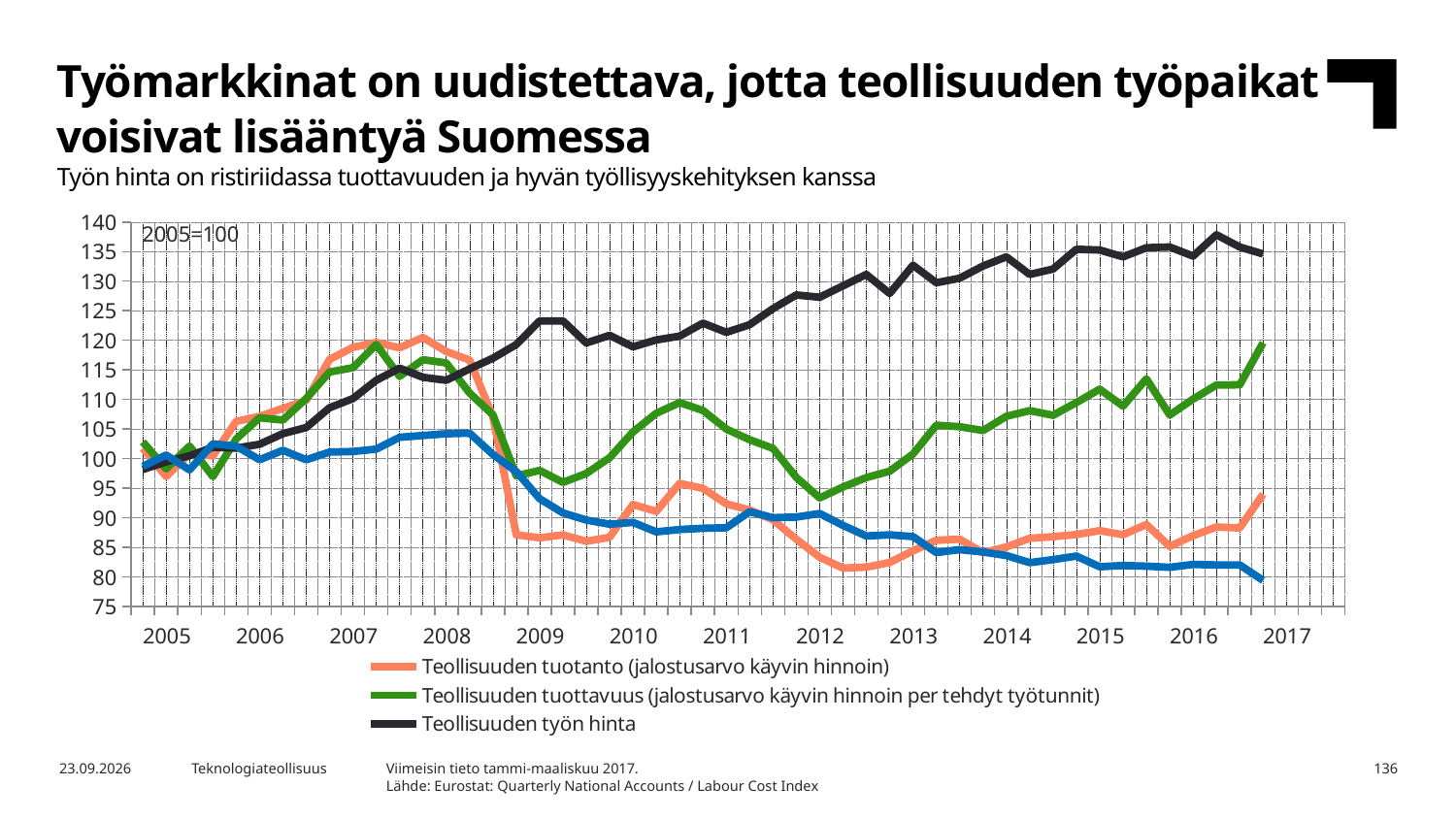
Which colour is used for the series 'Teollisuuden työn hinta'? Black What kind of chart is shown on the slide? Line chart Is the value of 'Teollisuuden työn hinta' at 2017 greater or less than 130? greater What base-year note is printed inside the chart area? 2005=100 Which of the legend series has the lowest value at 2012? Teollisuuden tuotanto (jalostusarvo käyvin hinnoin) Is the value of 'Teollisuuden tuotanto (jalostusarvo käyvin hinnoin)' at 2013 greater or less than 90? less How many series does the chart legend list? 3 At 2008, which is higher: 'Teollisuuden tuotanto' or 'Teollisuuden työn hinta'? Teollisuuden tuotanto Which series has the highest value at 2017? Teollisuuden työn hinta Is the value of 'Teollisuuden tuottavuus' at 2012 greater or less than 100? less Does 'Teollisuuden työn hinta' rise or fall overall from 2005 to 2017? Rise